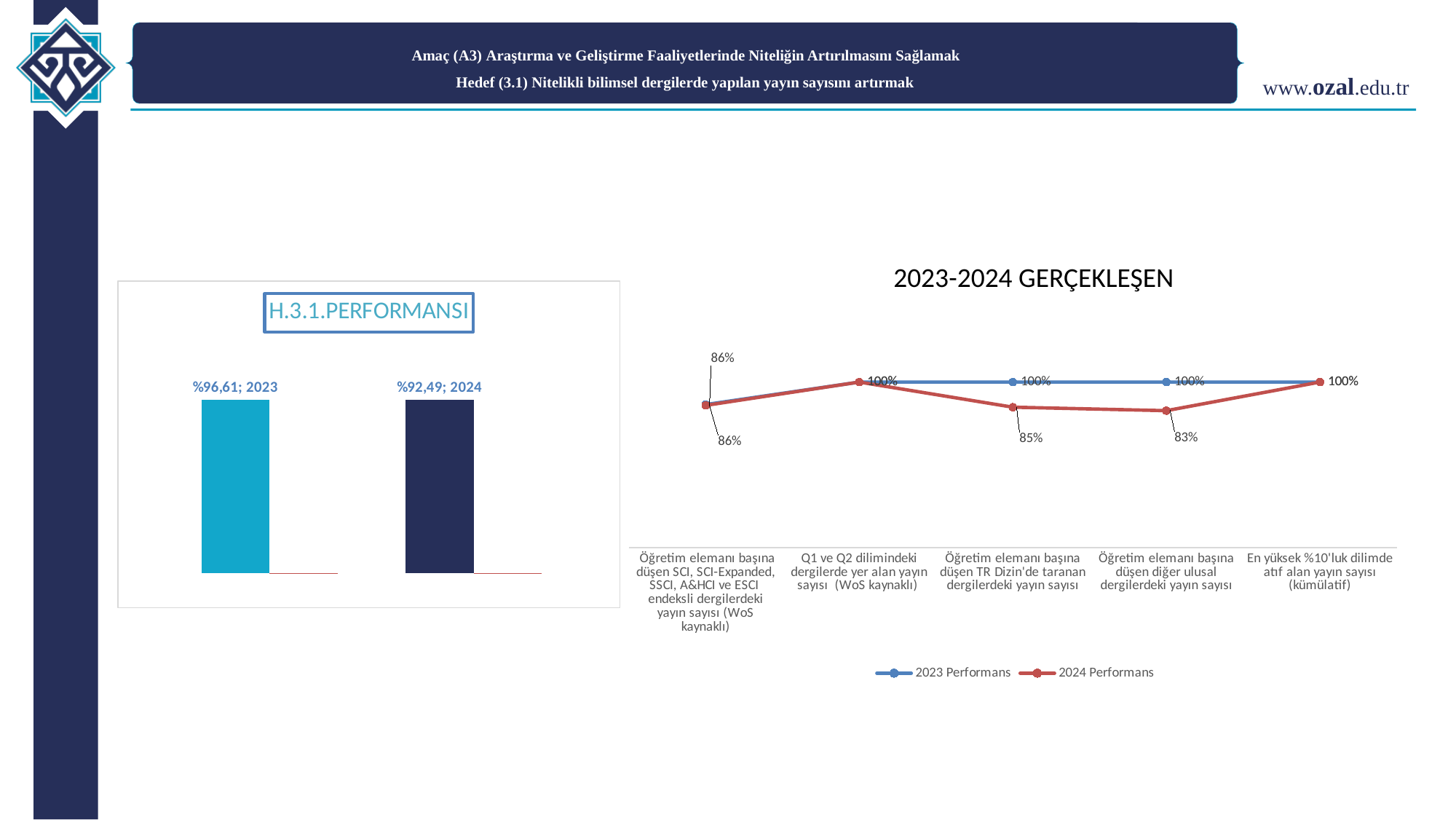
What kind of chart is the 2023-2024 GERÇEKLEŞEN chart? Line chart In the H.3.1.PERFORMANSI chart, which year has the higher value, 2023 or 2024? 2023 In the 2023-2024 GERÇEKLEŞEN chart, how many categories are shown on the x axis? 5 In the 2023-2024 GERÇEKLEŞEN chart, what is the 2023 Performans value for 'Q1 ve Q2 dilimindeki dergilerde yer alan yayın sayısı (WoS kaynaklı)'? 100% In the 2023-2024 GERÇEKLEŞEN chart, which category has the lowest 2024 Performans value? Öğretim elemanı başına düşen diğer ulusal dergilerdeki yayın sayısı In the 2023-2024 GERÇEKLEŞEN chart, what is the 2024 Performans value for 'Öğretim elemanı başına düşen diğer ulusal dergilerdeki yayın sayısı'? 83% What kind of chart is the H.3.1.PERFORMANSI chart? Bar chart In the 2023-2024 GERÇEKLEŞEN chart, what is the 2024 Performans value for 'Öğretim elemanı başına düşen TR Dizin'de taranan dergilerdeki yayın sayısı'? 85% In the H.3.1.PERFORMANSI chart, what is the value for 2023? %96,61 In the H.3.1.PERFORMANSI chart, what is the value for 2024? %92,49 In the H.3.1.PERFORMANSI chart, how many bars are plotted? 2 How many series does the legend of the 2023-2024 GERÇEKLEŞEN chart list? 2